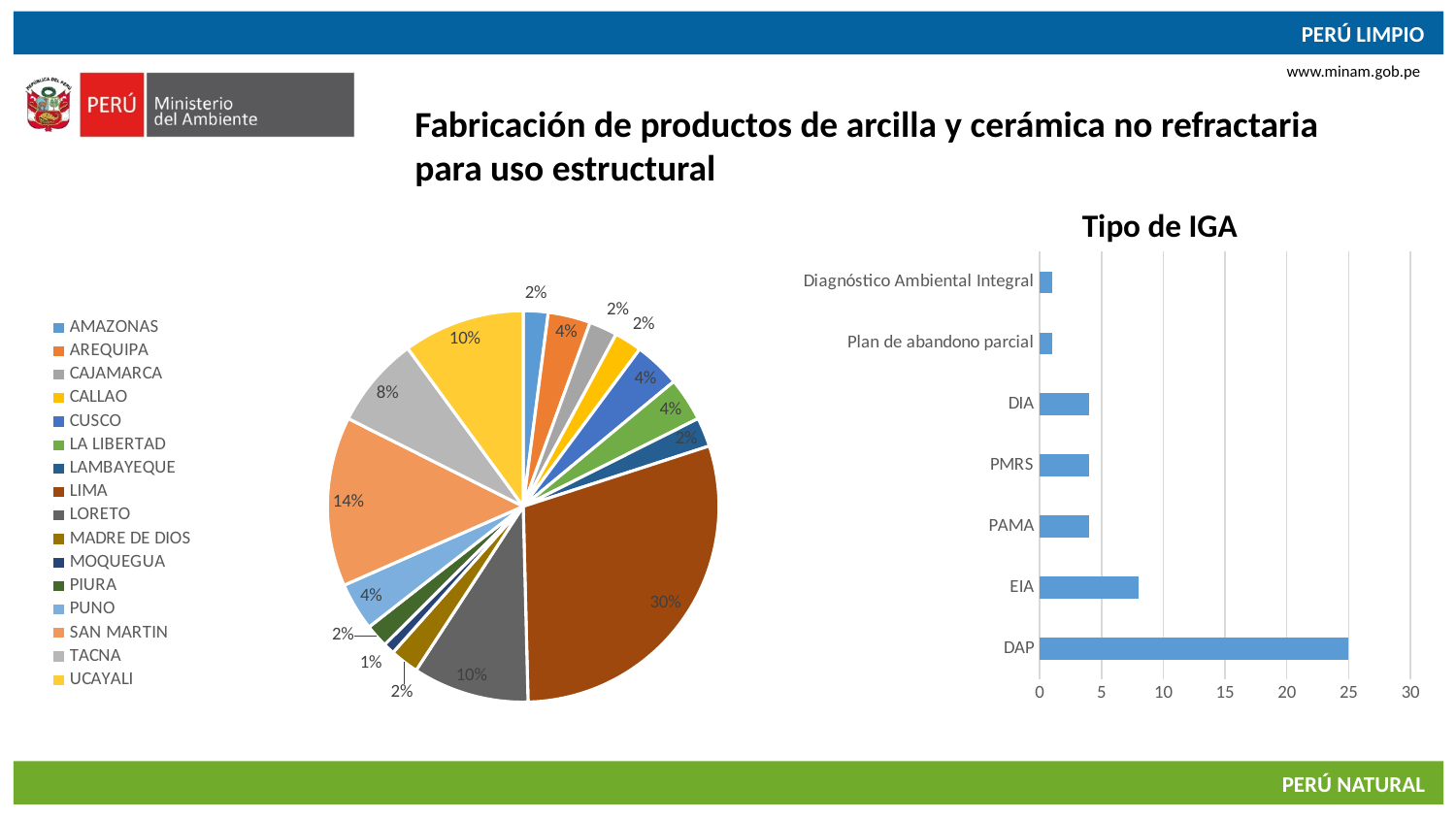
In the pie chart on the left, what share does LIMA have? 30% In the 'Tipo de IGA' chart, what is the value for DAP? 25 In the 'Tipo de IGA' chart, is the value for DIA greater or less than 5? less How many regions does the legend of the pie chart on the left list? 16 What kind of chart is the 'Tipo de IGA' chart on the right? bar chart What kind of chart is the chart on the left of the slide? pie chart How many categories are shown in the 'Tipo de IGA' chart? 7 In the 'Tipo de IGA' chart, is the value for EIA greater or less than 5? greater In the pie chart on the left, what share does SAN MARTIN have? 14% In the 'Tipo de IGA' chart, which is larger, EIA or PAMA? EIA In the 'Tipo de IGA' chart, which category has the highest value? DAP In the pie chart on the left, which region has the largest slice? LIMA